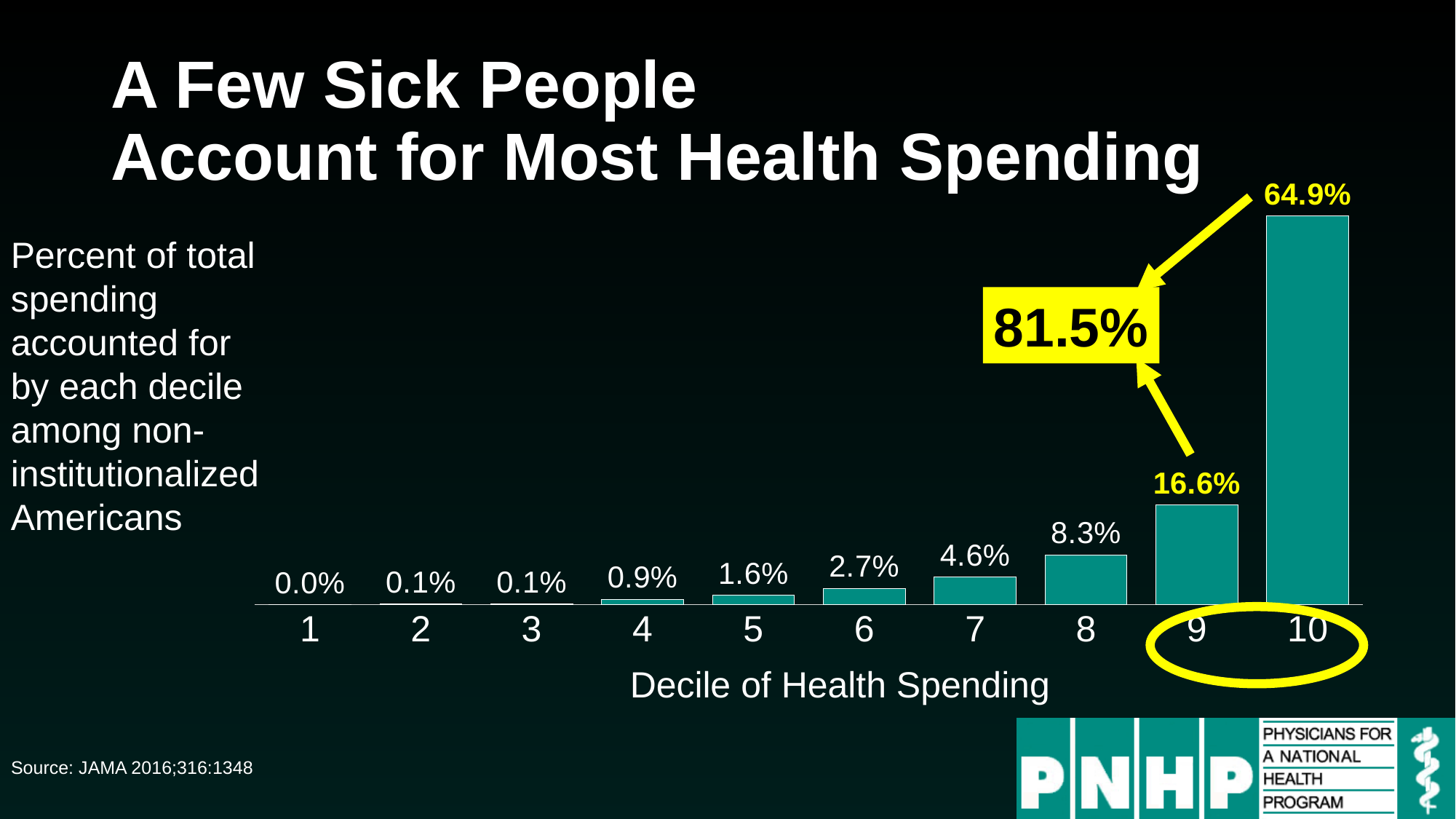
Which has a larger value, decile 7 or decile 8? Decile 8 What percent of total spending is accounted for by decile 10? 64.9% What kind of chart is shown on the slide? Bar chart Which decile accounts for the lowest percent of total spending? 1 What percent of total spending is accounted for by decile 5? 1.6% What is the x-axis label of the chart? Decile of Health Spending How many deciles are shown on the x axis? 10 What percent of total spending is accounted for by decile 9? 16.6% What percent of total spending is accounted for by decile 8? 8.3% Do the values rise or fall as the decile number increases along the x axis? Rise Which decile accounts for the highest percent of total spending? 10 What is the difference between the values for decile 10 and decile 9? 48.3%